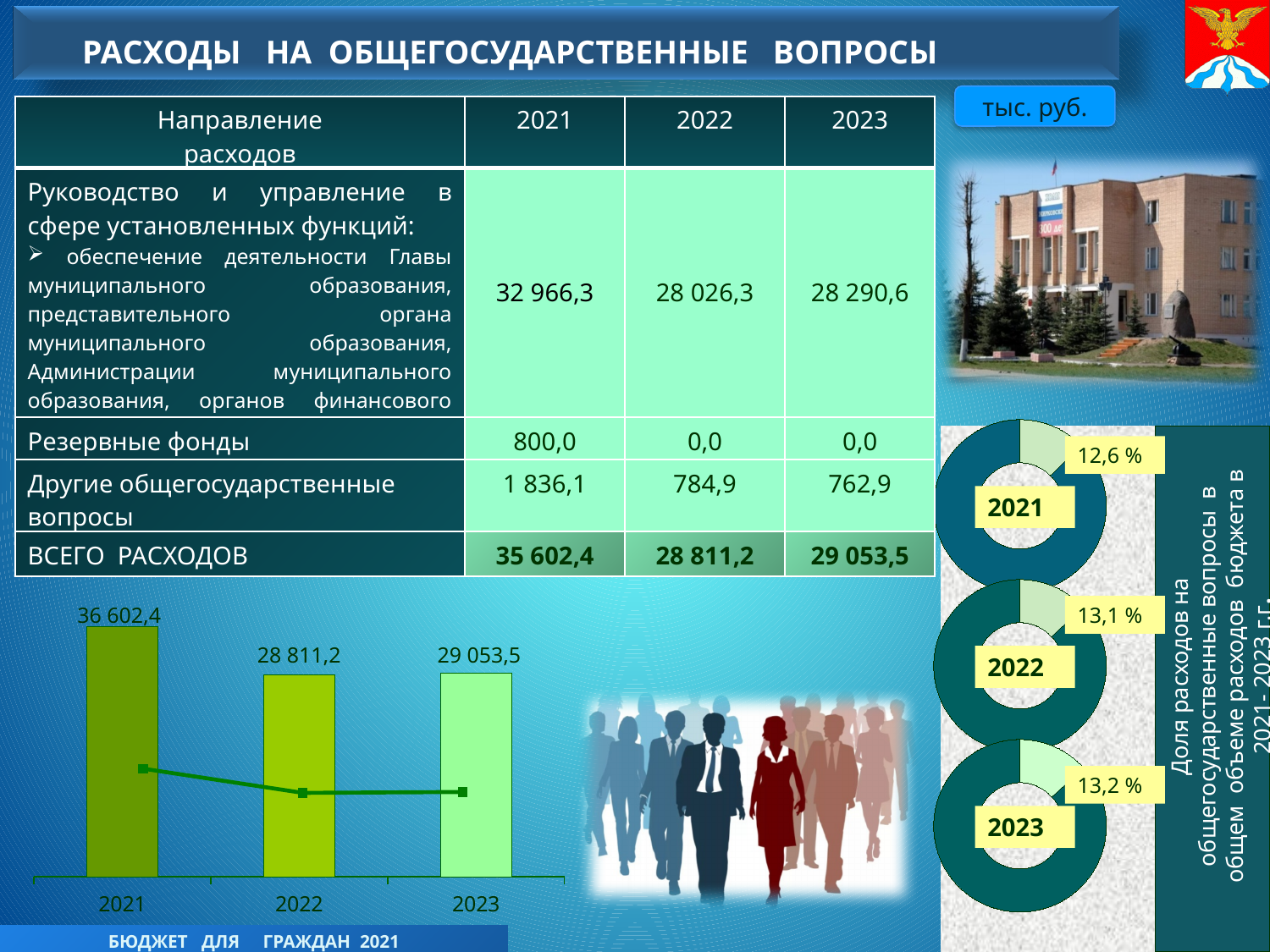
In the bar chart at the bottom left, what is the difference between the 2021 value and the 2022 value? 7 791,2 What kind of chart is shown at the bottom left of the slide? Bar chart In the bar chart at the bottom left, what is the value shown for 2023? 29 053,5 In the donut charts on the right, what share is shown for 2023? 13,2 % In the bar chart at the bottom left, which year has the highest value? 2021 In the bar chart at the bottom left, what is the value shown for 2022? 28 811,2 In the bar chart at the bottom left, which is larger: the value for 2022 or the value for 2023? 2023 In the bar chart at the bottom left, which year has the lowest value? 2022 In the donut charts on the right, what share is shown for 2021? 12,6 % In the bar chart at the bottom left, what is the difference between the 2023 value and the 2022 value? 242,3 In the bar chart at the bottom left, what is the value shown for 2021? 36 602,4 How many years are shown on the x axis of the bar chart at the bottom left? 3